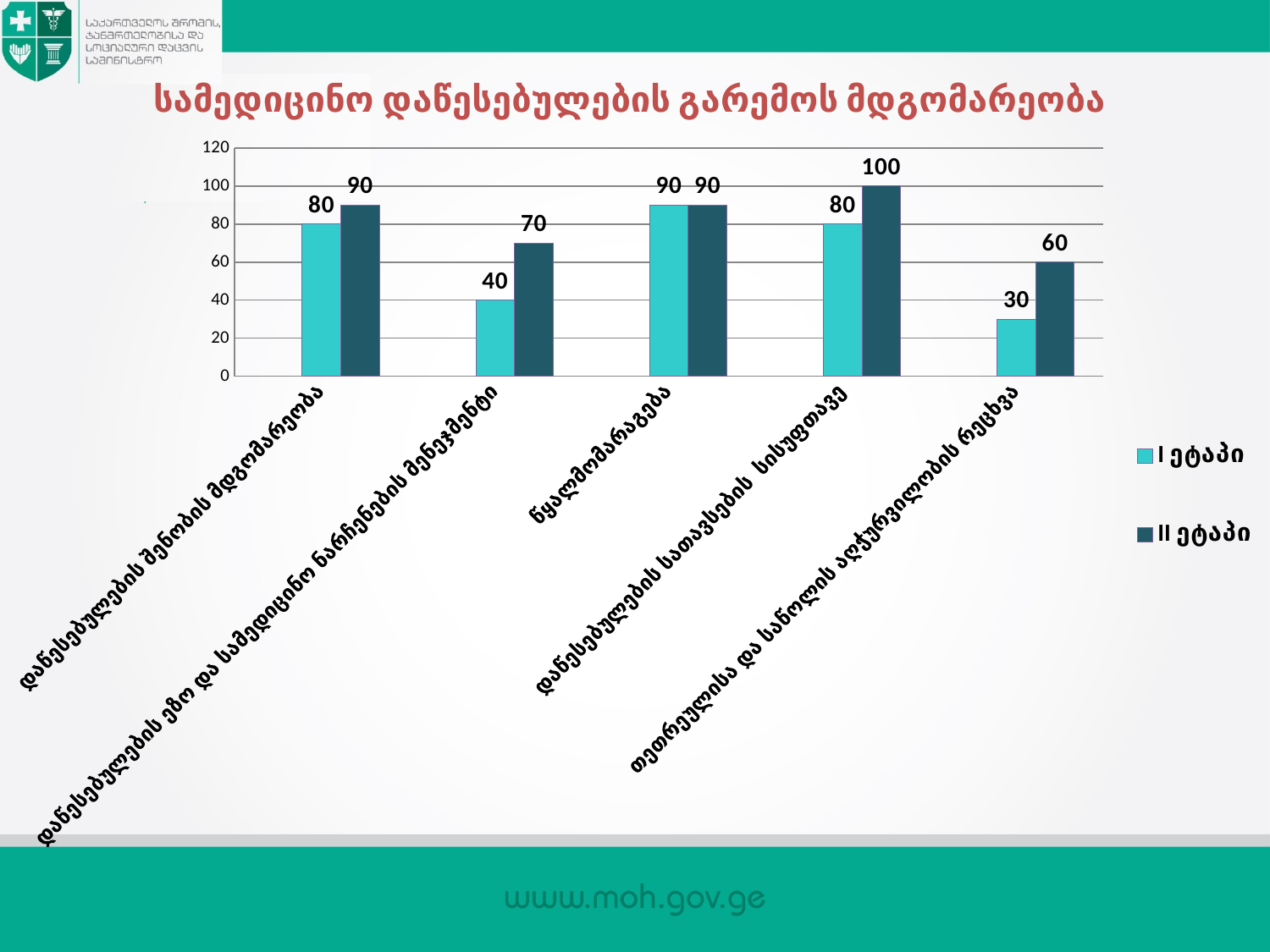
Which category has the highest value for "II ეტაპი"? დაწესებულების სათავსების სისუფთავე What kind of chart is shown on the slide? Bar chart What is the value for "I ეტაპი" in the category "თეთრეულისა და საწოლის აღჭურვილობის რეცხვა"? 30 Which category has the lowest value for "I ეტაპი"? თეთრეულისა და საწოლის აღჭურვილობის რეცხვა What is the value for "II ეტაპი" in the category "დაწესებულების სათავსების სისუფთავე"? 100 Which is larger for "დაწესებულების შენობის მდგომარეობა": the "I ეტაპი" value or the "II ეტაპი" value? II ეტაპი What is the difference between the "II ეტაპი" and "I ეტაპი" values for "დაწესებულების ეზო და სამედიცინო ნარჩენების მენეჯმენტი"? 30 How many categories are shown on the x axis? 5 Which series is shown in the darker teal colour? II ეტაპი How many series does the legend list? 2 What is the value for "I ეტაპი" in the category "წყალმომარაგება"? 90 What is the title of the chart? სამედიცინო დაწესებულების გარემოს მდგომარეობა